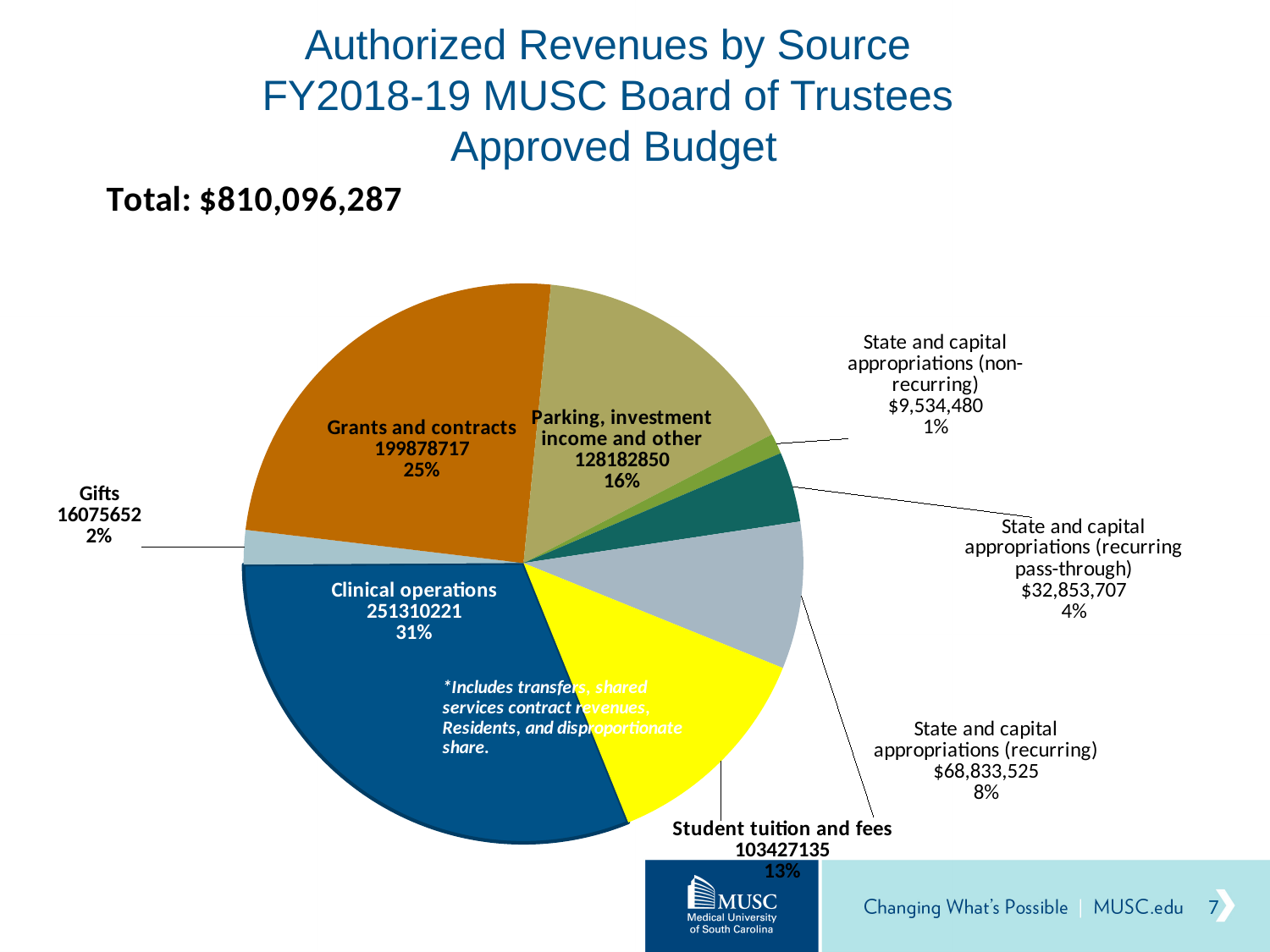
What is the value shown for Parking, investment income and other? 128182850 Which revenue source has the smallest share of the pie? State and capital appropriations (non-recurring) What type of chart is shown on the slide? pie chart What percentage share does Grants and contracts have? 25% Which revenue source has the largest share of the pie? Clinical operations What is the difference in percentage share between Clinical operations and Grants and contracts? 6% What percentage share does State and capital appropriations (recurring pass-through) have? 4% What is the value shown for State and capital appropriations (recurring)? $68,833,525 What is the value shown for Clinical operations? 251310221 What total is stated on the slide for the authorized revenues? $810,096,287 How many slices does the pie chart have? 8 Which is larger, Student tuition and fees or Gifts? Student tuition and fees